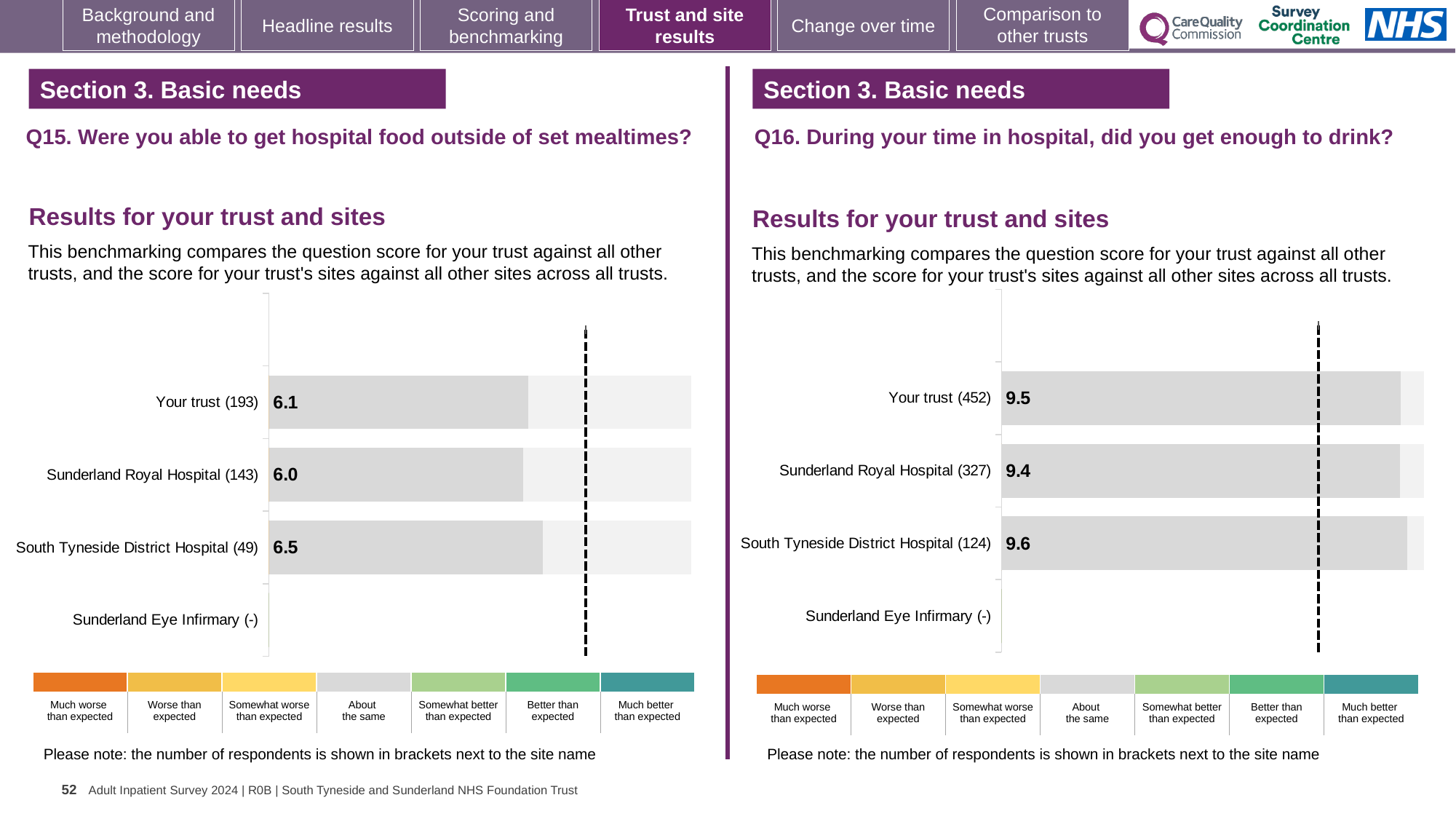
What kind of chart is used on the Q15 chart (left)? Bar chart On the Q15 chart (left), what is the score for Your trust? 6.1 On the Q15 chart (left), which site has the highest score? South Tyneside District Hospital On the Q16 chart (right), which is larger: the score for Your trust or the score for Sunderland Royal Hospital? Your trust On the Q16 chart (right), what is the difference between the scores for South Tyneside District Hospital and Sunderland Royal Hospital? 0.2 On the Q16 chart (right), what is the score for Your trust? 9.5 On the Q15 chart (left), how many respondents are shown in brackets for Your trust? 193 On the Q16 chart (right), which site has the highest score? South Tyneside District Hospital On the Q16 chart (right), what is the score for Sunderland Royal Hospital? 9.4 On the Q15 chart (left), what is the difference between the scores for South Tyneside District Hospital and Sunderland Royal Hospital? 0.5 On the Q15 chart (left), which site has the lowest score shown? Sunderland Royal Hospital On the Q15 chart (left), what is the score for South Tyneside District Hospital? 6.5